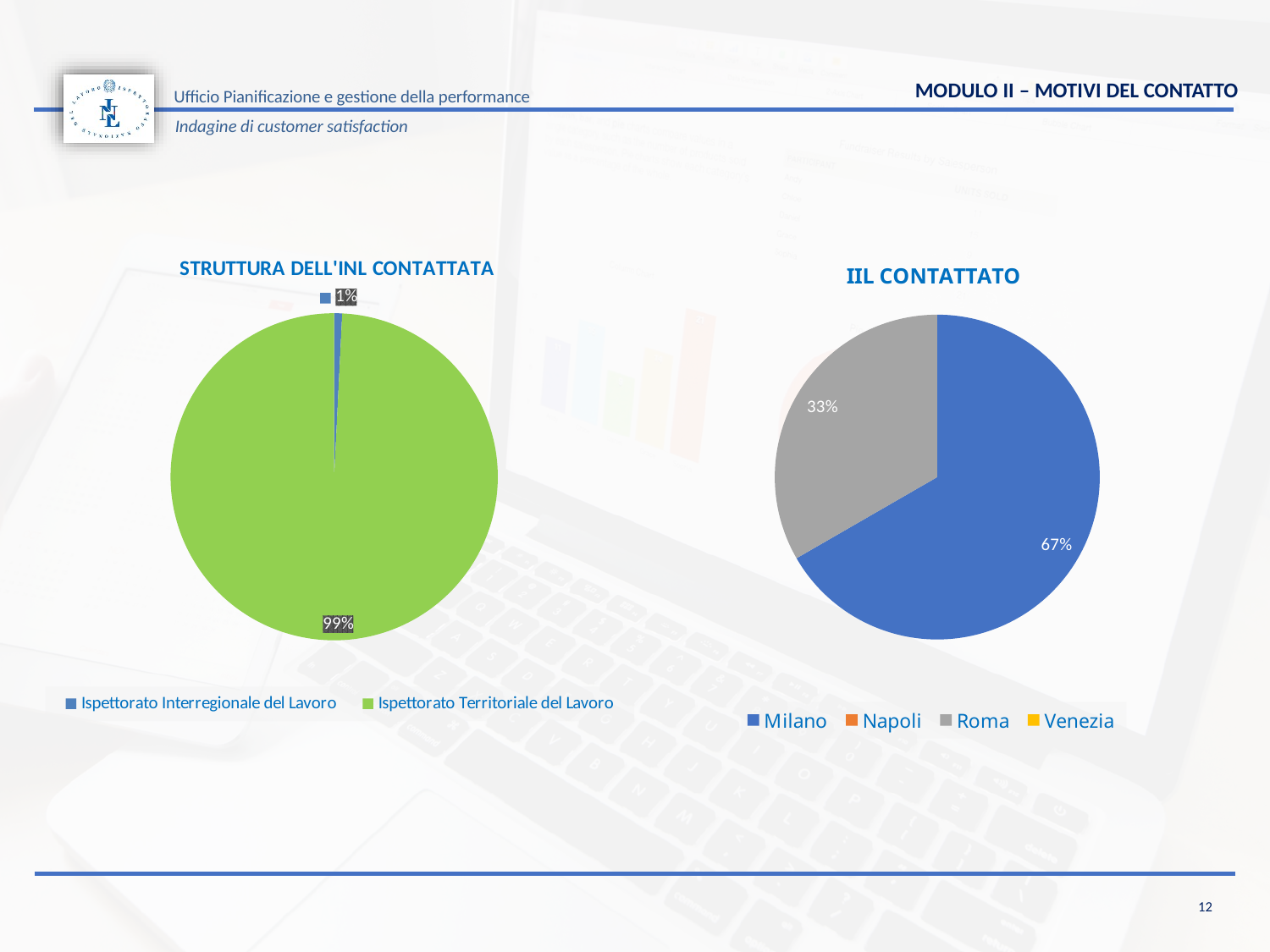
In the 'STRUTTURA DELL'INL CONTATTATA' chart, which colour represents Ispettorato Territoriale del Lavoro? Green In the 'IIL CONTATTATO' chart, which colour represents Roma? Grey In the 'STRUTTURA DELL'INL CONTATTATA' chart, which category has the largest slice? Ispettorato Territoriale del Lavoro What kind of chart is 'STRUTTURA DELL'INL CONTATTATA'? Pie chart In the 'STRUTTURA DELL'INL CONTATTATA' chart, what share does Ispettorato Interregionale del Lavoro have? 1% In the 'IIL CONTATTATO' chart, what share does Milano have? 67% In the 'IIL CONTATTATO' chart, how many entries does the legend list? 4 In the 'IIL CONTATTATO' chart, what share does Roma have? 33% In the 'STRUTTURA DELL'INL CONTATTATA' chart, how many entries does the legend list? 2 In the 'IIL CONTATTATO' chart, what is the difference between the Milano and Roma shares? 34% In the 'IIL CONTATTATO' chart, which city has the largest slice? Milano